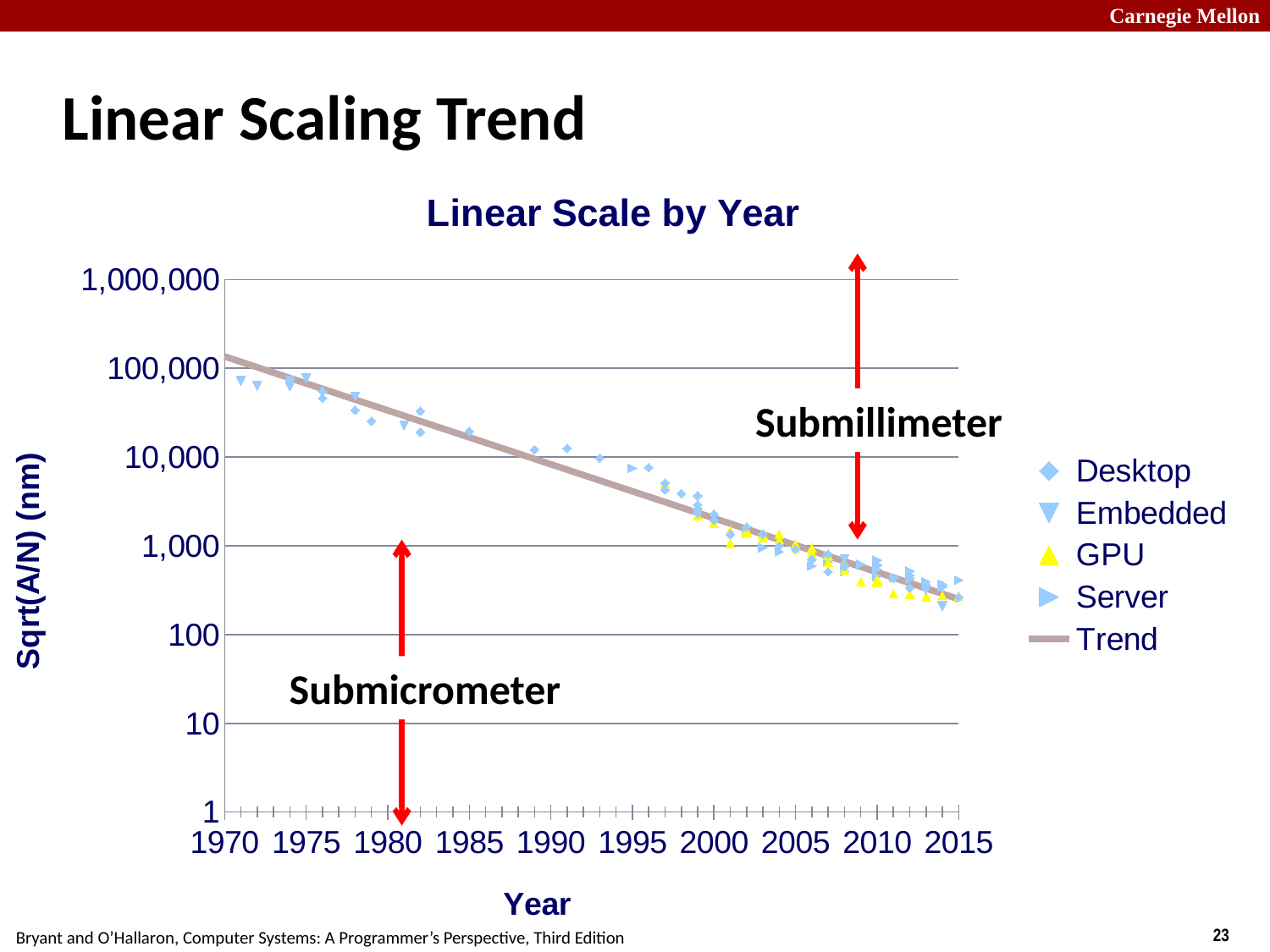
Is the value of the Trend line at 1970 greater or less than 100,000? greater Which is larger, the Trend line value at 1970 or at 2015? 1970 What is the title of the chart? Linear Scale by Year What kind of chart is shown on the slide? scatter chart Do the plotted values rise or fall as the year increases along the x axis? fall Are the GPU values plotted around 2012 greater or less than 1,000? less Are the Desktop values plotted around 1980 greater or less than 10,000? greater How many series does the legend list? 5 What is the label of the y axis? Sqrt(A/N) (nm)